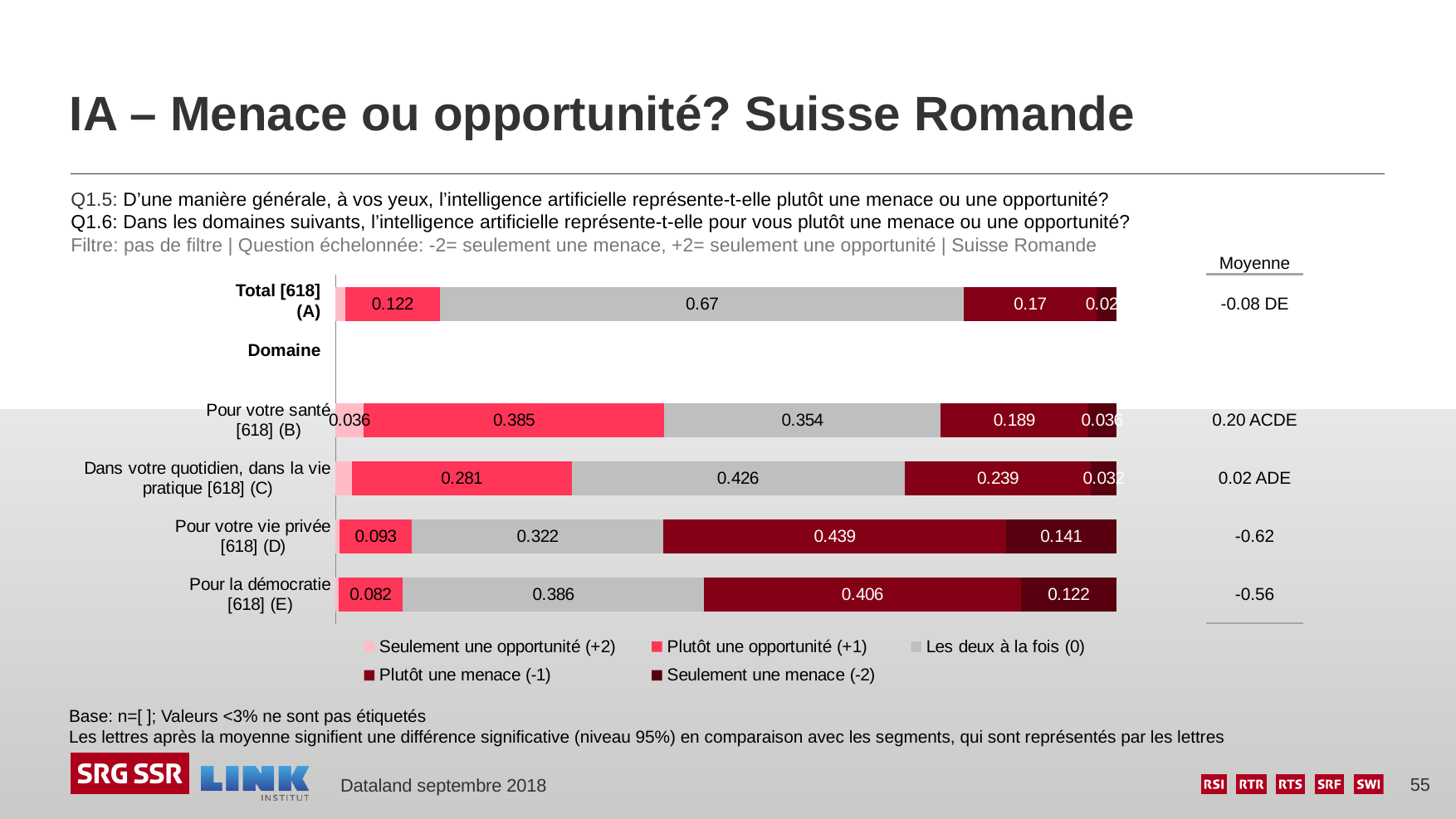
Which legend entry is shown in light grey? Les deux à la fois (0) Which category has the lowest value for "Les deux à la fois (0)"? Pour votre vie privée [618] (D) What is the value of "Les deux à la fois (0)" for Total [618] (A)? 0.67 What is the difference between the "Plutôt une opportunité (+1)" values for Pour votre santé [618] (B) and Dans votre quotidien, dans la vie pratique [618] (C)? 0.104 What is the value of "Plutôt une menace (-1)" for Pour votre vie privée [618] (D)? 0.439 How many bars are plotted in the chart? 5 Which category has the highest value for "Plutôt une menace (-1)"? Pour votre vie privée [618] (D) What is the value of "Plutôt une opportunité (+1)" for Pour votre santé [618] (B)? 0.385 Which has the larger "Seulement une menace (-2)" value: Pour votre vie privée [618] (D) or Pour la démocratie [618] (E)? Pour votre vie privée [618] (D) How many series does the legend list? 5 What kind of chart is shown on the slide? Stacked bar chart What is the Moyenne shown for Pour la démocratie [618] (E)? -0.56